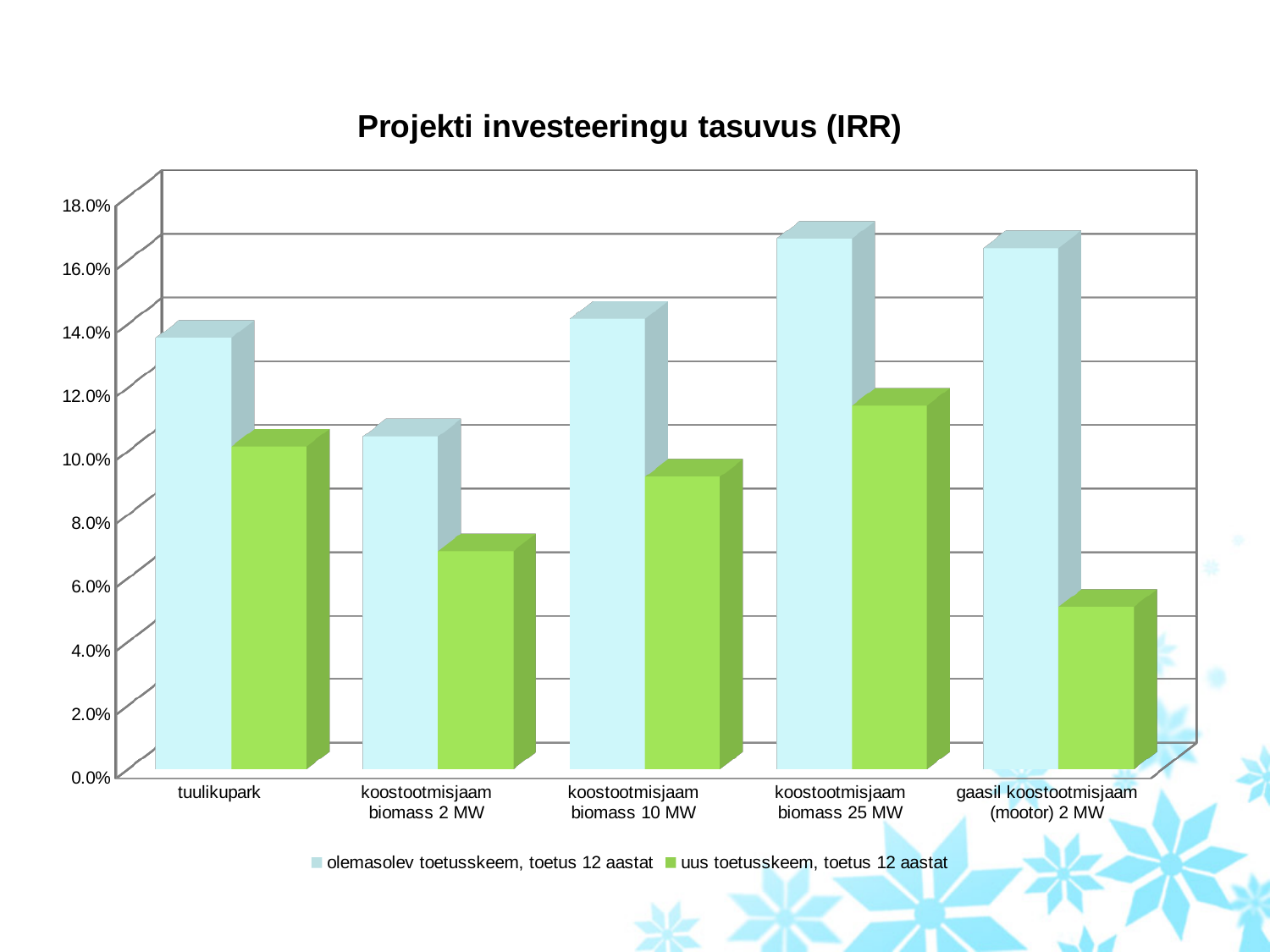
Is the value for gaasil koostootmisjaam (mootor) 2 MW under 'uus toetusskeem, toetus 12 aastat' greater or less than 6.0%? less What is the title of the chart? Projekti investeeringu tasuvus (IRR) What kind of chart is shown on the slide? bar chart For gaasil koostootmisjaam (mootor) 2 MW, which series has the larger value: 'olemasolev toetusskeem, toetus 12 aastat' or 'uus toetusskeem, toetus 12 aastat'? olemasolev toetusskeem, toetus 12 aastat How many series does the chart's legend list? 2 Is the value for tuulikupark under 'olemasolev toetusskeem, toetus 12 aastat' greater or less than 12.0%? greater Which series is shown in green in the chart? uus toetusskeem, toetus 12 aastat Is the value for koostootmisjaam biomass 2 MW under 'uus toetusskeem, toetus 12 aastat' greater or less than 8.0%? less Which category has the lowest value for the series 'olemasolev toetusskeem, toetus 12 aastat'? koostootmisjaam biomass 2 MW How many categories are shown on the x axis of the chart? 5 Which category has the lowest value for the series 'uus toetusskeem, toetus 12 aastat'? gaasil koostootmisjaam (mootor) 2 MW Which category has the highest value for the series 'uus toetusskeem, toetus 12 aastat'? koostootmisjaam biomass 25 MW